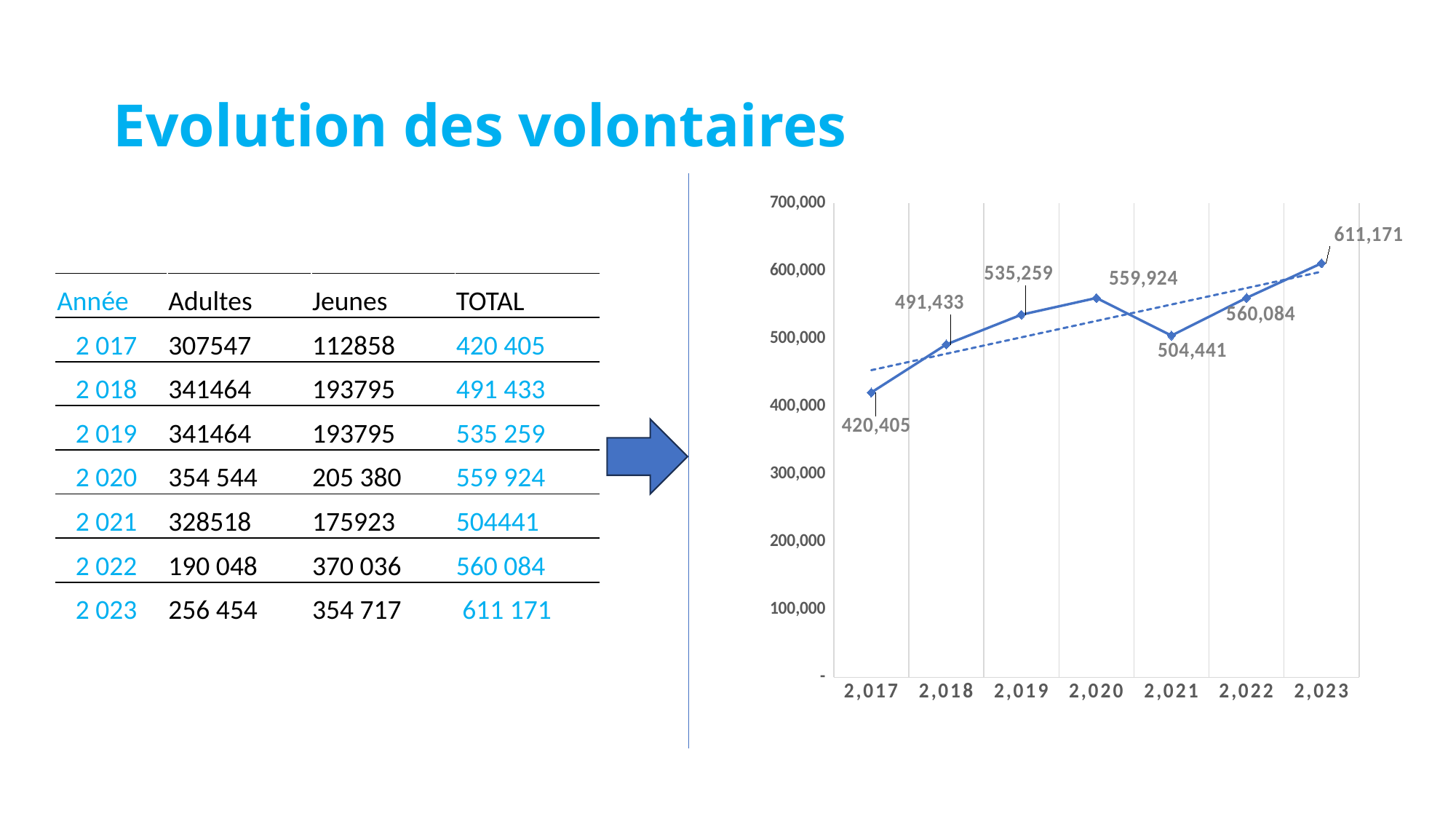
What is the difference between the values for 2,020 and 2,021 on the line chart? 55,483 Which year has the highest value on the line chart? 2,023 What is the value plotted for 2,023 on the line chart? 611,171 What kind of chart is shown on the right of the slide? line chart What is the difference between the values for 2,023 and 2,017 on the line chart? 190,766 Do the values on the line chart generally rise or fall from 2,017 to 2,023? rise What is the value plotted for 2,021 on the line chart? 504,441 Which is larger on the line chart, the value for 2,019 or the value for 2,021? 2,019 Which year has the lowest value on the line chart? 2,017 How many data points are plotted on the line chart? 7 What is the value plotted for 2,017 on the line chart? 420,405 Is the value for 2,017 on the line chart greater or less than 500,000? less